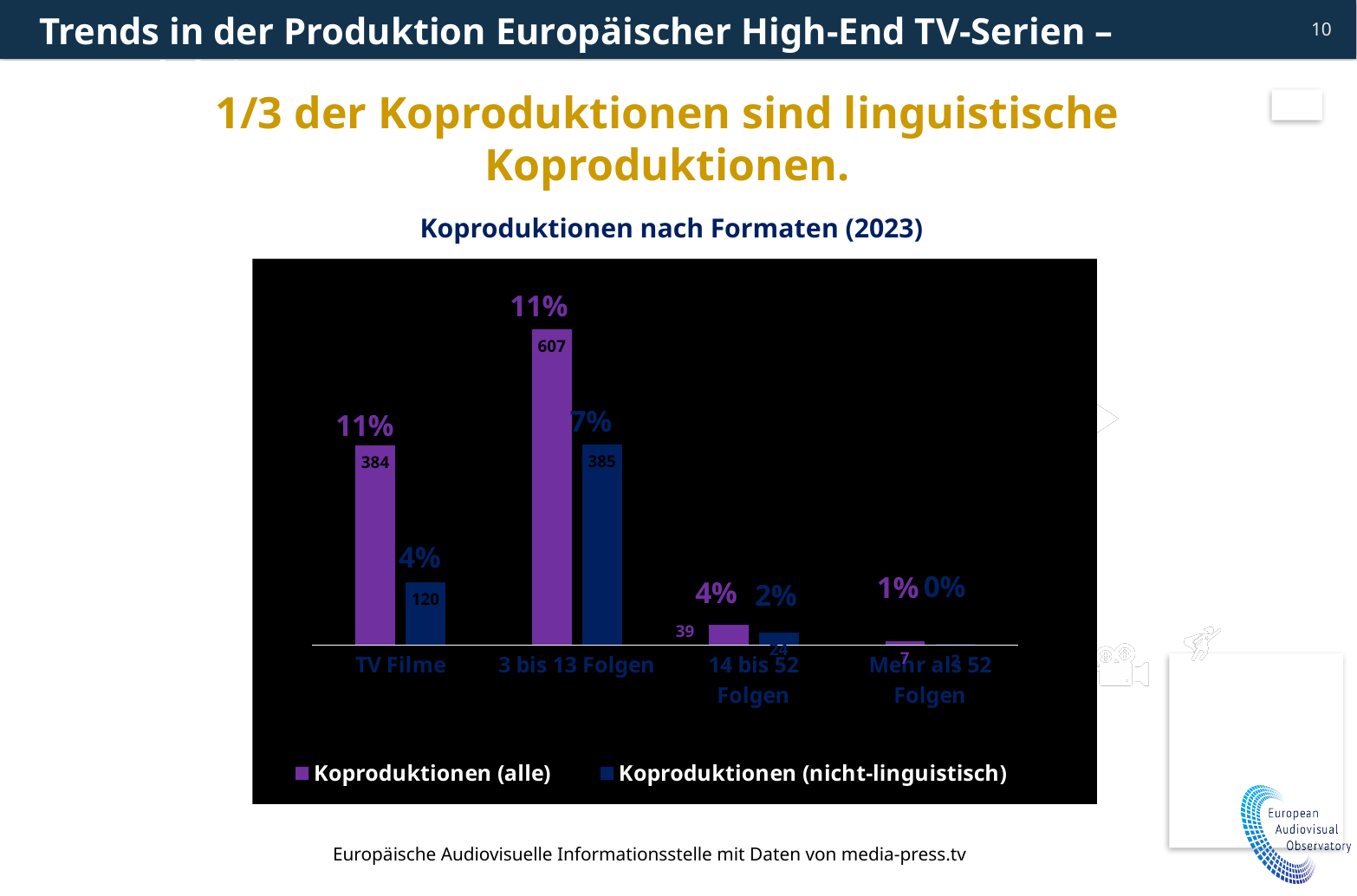
What is the title of the chart? Koproduktionen nach Formaten (2023) Which category has the highest value for Koproduktionen (alle)? 3 bis 13 Folgen What is the difference between Koproduktionen (alle) and Koproduktionen (nicht-linguistisch) for TV Filme? 264 What is the value of Koproduktionen (nicht-linguistisch) for TV Filme? 120 Which category has the lowest value for Koproduktionen (alle)? Mehr als 52 Folgen Which is larger for 3 bis 13 Folgen: Koproduktionen (alle) or Koproduktionen (nicht-linguistisch)? Koproduktionen (alle) What is the value of Koproduktionen (alle) for TV Filme? 384 What is the value of Koproduktionen (alle) for 3 bis 13 Folgen? 607 How many format categories are shown on the x axis? 4 How many series does the legend list? 2 What kind of chart is shown on the slide? bar chart What is the value of Koproduktionen (nicht-linguistisch) for 3 bis 13 Folgen? 385